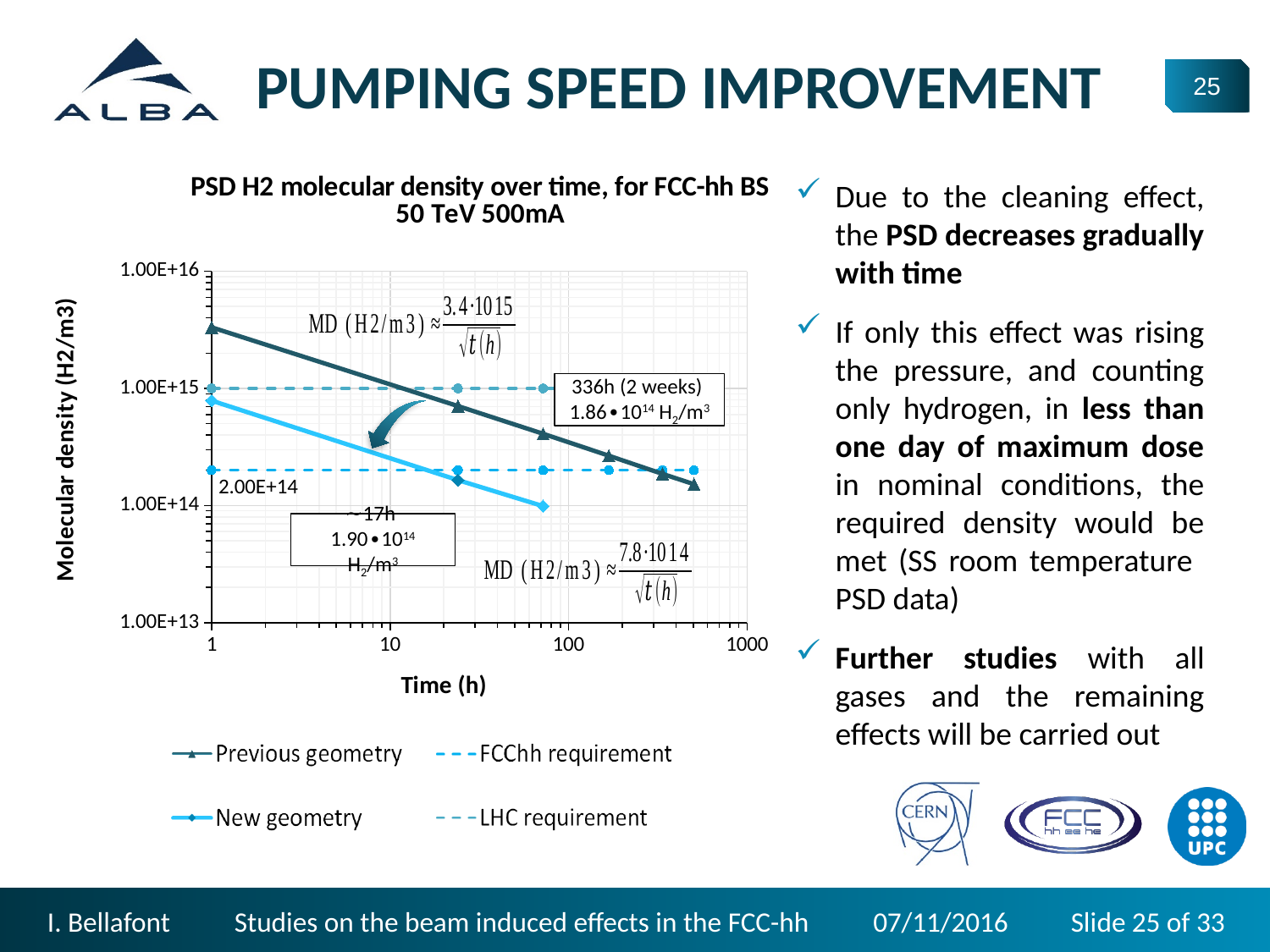
What kind of chart is shown on the slide? Line chart Is the Previous geometry value at 1 h greater or less than 1.00E+15? greater How many series does the chart legend list? 4 What is the value of the LHC requirement line? 1.00E+15 What is the title of the x axis? Time (h) Does the New geometry series rise or fall as time increases? Fall According to the annotation, after how many hours does the Previous geometry reach the FCChh requirement? 336h (2 weeks) According to the annotation, after approximately how many hours does the New geometry reach the FCChh requirement? ~17h Does the Previous geometry series rise or fall as time increases? Fall What is the value of the FCChh requirement line? 2.00E+14 At 1 h, which series has the higher molecular density, Previous geometry or New geometry? Previous geometry Is the New geometry value at 1 h greater or less than 1.00E+15? less